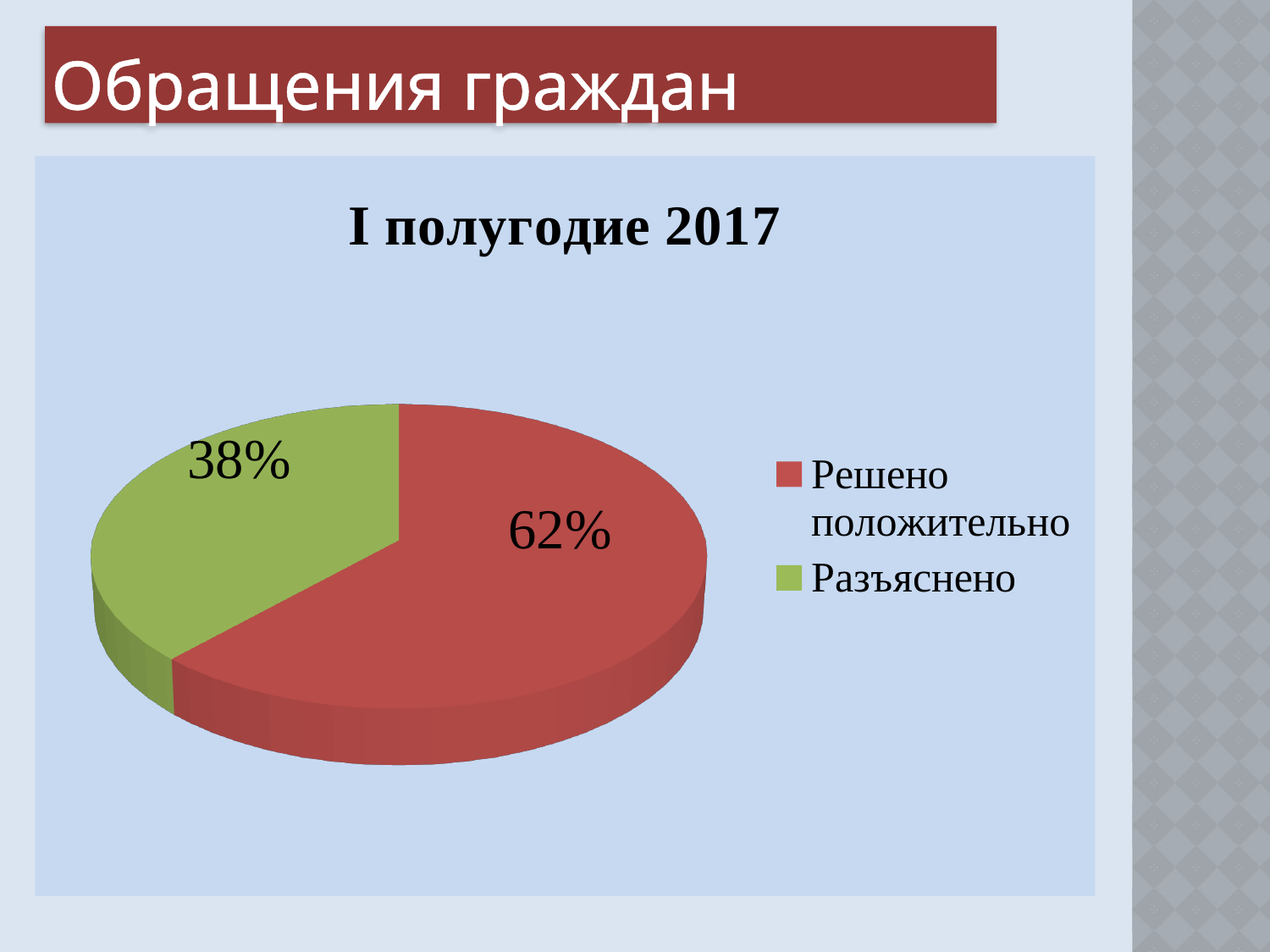
What is the difference in percentage points between "Решено положительно" and "Разъяснено"? 24 What kind of chart is shown on the slide? pie chart How many slices does the pie chart have? 2 Which slice of the pie is the largest? Решено положительно What colour is the slice for "Разъяснено"? green What share of the pie is labelled "Разъяснено"? 38% How many entries does the legend list? 2 What is the title of the chart? I полугодие 2017 Is the share for "Решено положительно" greater or less than 50%? greater Which is larger, the share for "Решено положительно" or the share for "Разъяснено"? Решено положительно Which slice of the pie is the smallest? Разъяснено What share of the pie is labelled "Решено положительно"? 62%